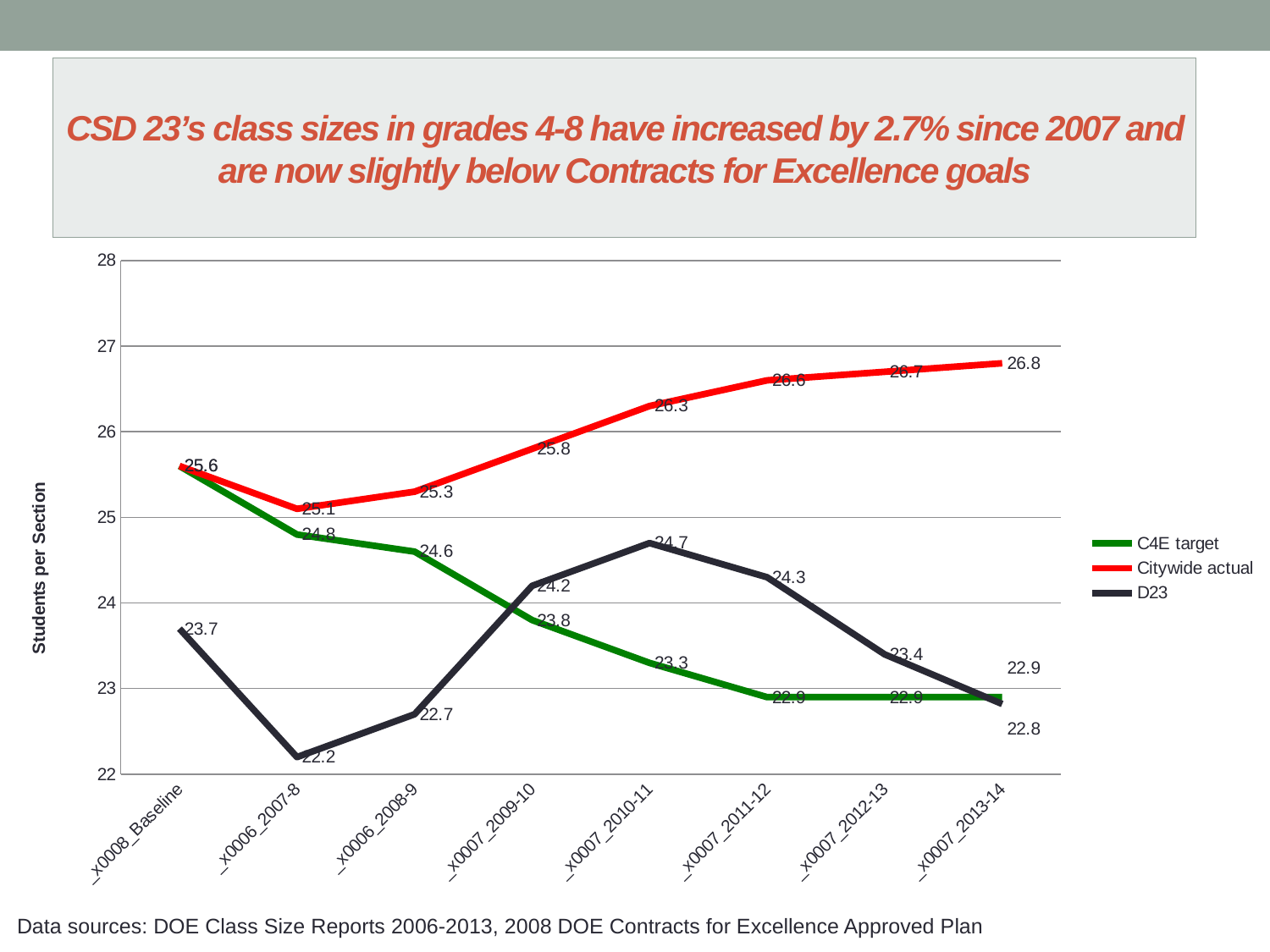
How many points along the x axis does each line have? 8 What is the C4E target value for 2009-10? 23.8 What kind of chart is shown on the slide? Line chart How many series does the legend list? 3 In which year is the D23 value lowest? 2007-8 What is the title of the y axis? Students per Section What is the difference between the Citywide actual value and the C4E target value in 2013-14? 3.9 In which year is the Citywide actual value highest? 2013-14 What is the D23 value at the Baseline point? 23.7 What is the Citywide actual value for 2013-14? 26.8 Does the Citywide actual line rise or fall from 2008-9 to 2013-14? Rise Which is larger in 2010-11, the D23 value or the C4E target value? D23